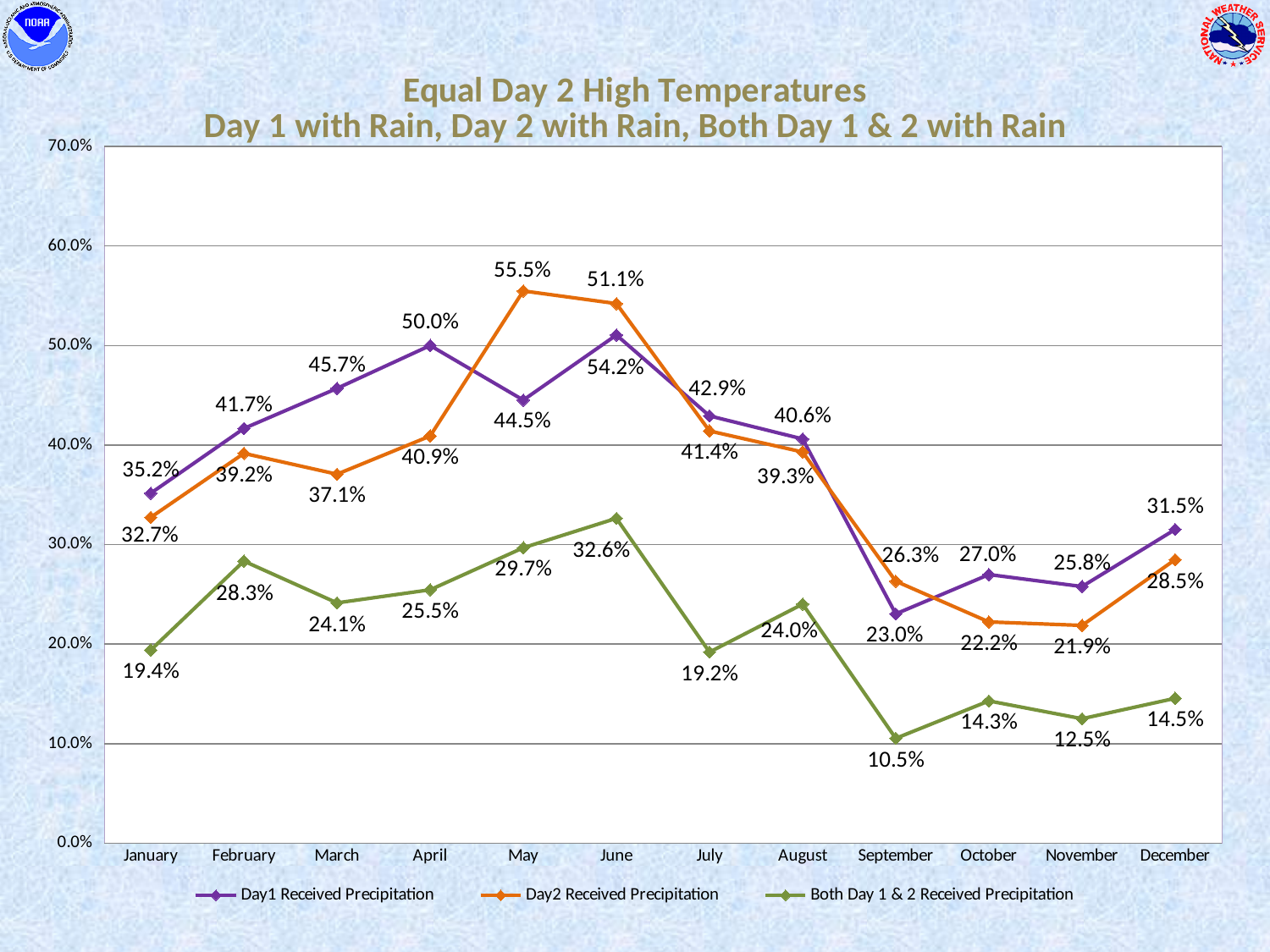
In which month is the Both Day 1 & 2 Received Precipitation series highest? June What is the value for Both Day 1 & 2 Received Precipitation in September? 10.5% How many series does the legend list? 3 What kind of chart is shown on the slide? Line chart In which month is the Day2 Received Precipitation series highest? May What is the value for Day1 Received Precipitation in April? 50.0% How many months are plotted along the x axis? 12 What is the difference between Day1 Received Precipitation and Day2 Received Precipitation in January? 2.5 percentage points In October, which is larger: Day1 Received Precipitation or Day2 Received Precipitation? Day1 Received Precipitation What is the value for Day2 Received Precipitation in May? 55.5% Does the Day1 Received Precipitation series rise or fall from January to April? Rise In which month is the Day1 Received Precipitation series lowest? September